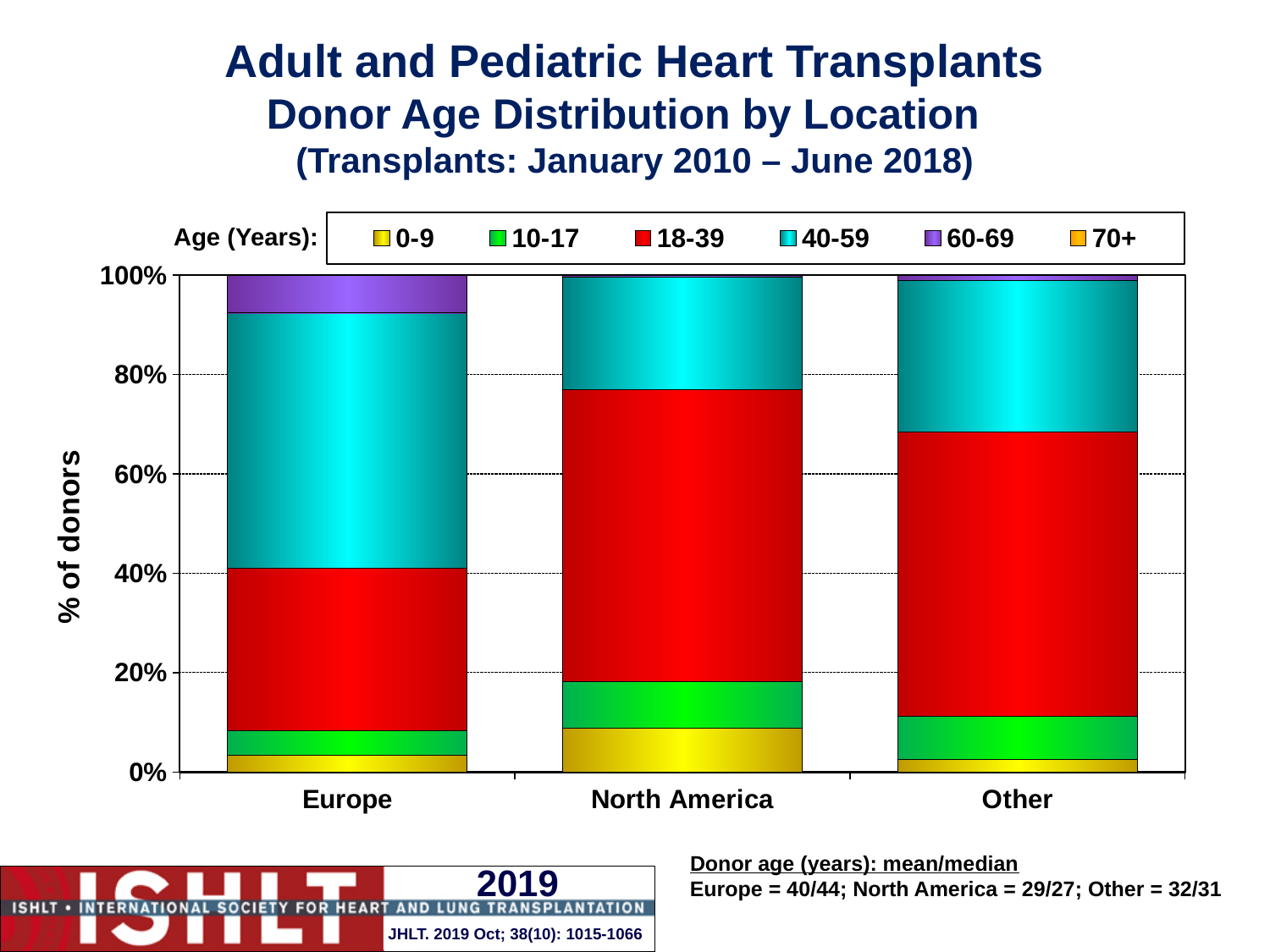
Which location has the smallest 40-59 donor age share? North America Which location has the largest 60-69 donor age share? Europe Is the 18-39 share for North America greater or less than 40%? greater What kind of chart is shown on the slide? Stacked bar chart What is the label on the y axis of the chart? % of donors Is the 0-9 share larger for North America or for Other? North America How many locations are shown on the x axis of the chart? 3 How many age groups does the legend list? 6 Which location has the largest 0-9 donor age share? North America Which location has the largest 40-59 donor age share? Europe Is the 40-59 share for Europe greater or less than 40%? greater Is the 40-59 share larger for Europe or for North America? Europe